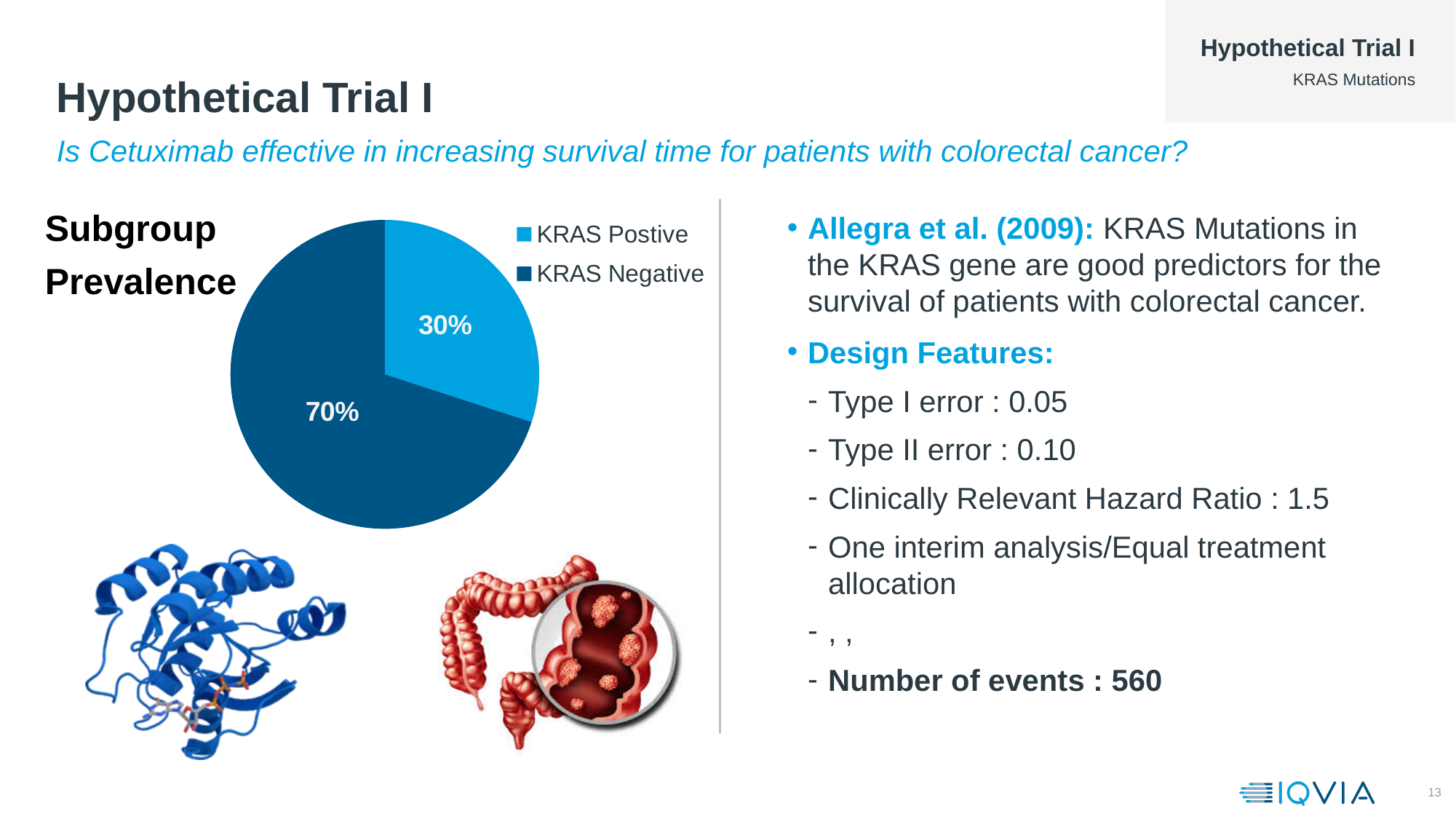
What kind of chart is shown on the slide? pie chart Which slice of the pie is the largest? KRAS Negative Which slice of the pie is the smallest? KRAS Postive What is the difference in percentage points between the KRAS Negative and KRAS Positive slices? 40 percentage points How many slices does the pie chart have? 2 Which legend entry is shown in the darker blue colour? KRAS Negative Which is larger, the KRAS Positive slice or the KRAS Negative slice? KRAS Negative What share of the pie is KRAS Negative? 70% How many entries does the legend list? 2 What is the label to the left of the pie chart? Subgroup Prevalence Is the value for KRAS Positive greater or less than 50%? less What share of the pie is KRAS Positive? 30%